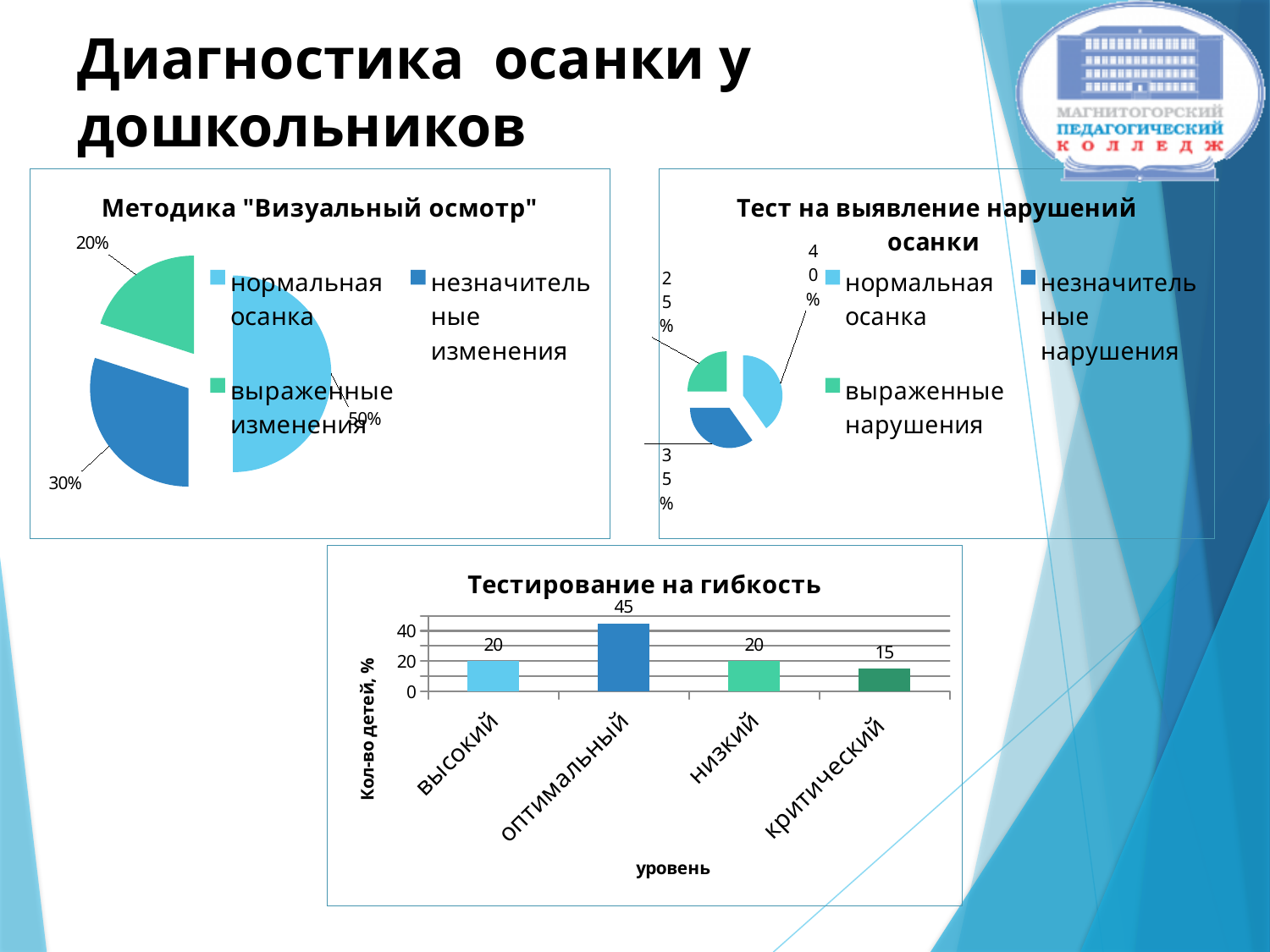
What type of chart is "Тестирование на гибкость"? bar chart In the chart "Тестирование на гибкость", what is the label of the vertical axis? Кол-во детей, % In the chart "Тест на выявление нарушений осанки", what is the difference between the shares for незначительные нарушения and выраженные нарушения? 10% In the chart "Методика "Визуальный осмотр"", which category has the smallest slice? выраженные изменения In the chart "Тест на выявление нарушений осанки", what percentage is shown for нормальная осанка? 40% In the chart "Тестирование на гибкость", which level has the lowest value? критический In the chart "Методика "Визуальный осмотр"", what share of the pie is labelled for нормальная осанка? 50% In the chart "Тест на выявление нарушений осанки", what percentage is shown for выраженные нарушения? 25% In the chart "Тестирование на гибкость", what is the difference between the values for оптимальный and критический? 30 In the chart "Тестирование на гибкость", what is the value for оптимальный? 45 In the chart "Методика "Визуальный осмотр"", what percentage is shown for незначительные изменения? 30% In the chart "Методика "Визуальный осмотр"", how many slices does the pie have? 3